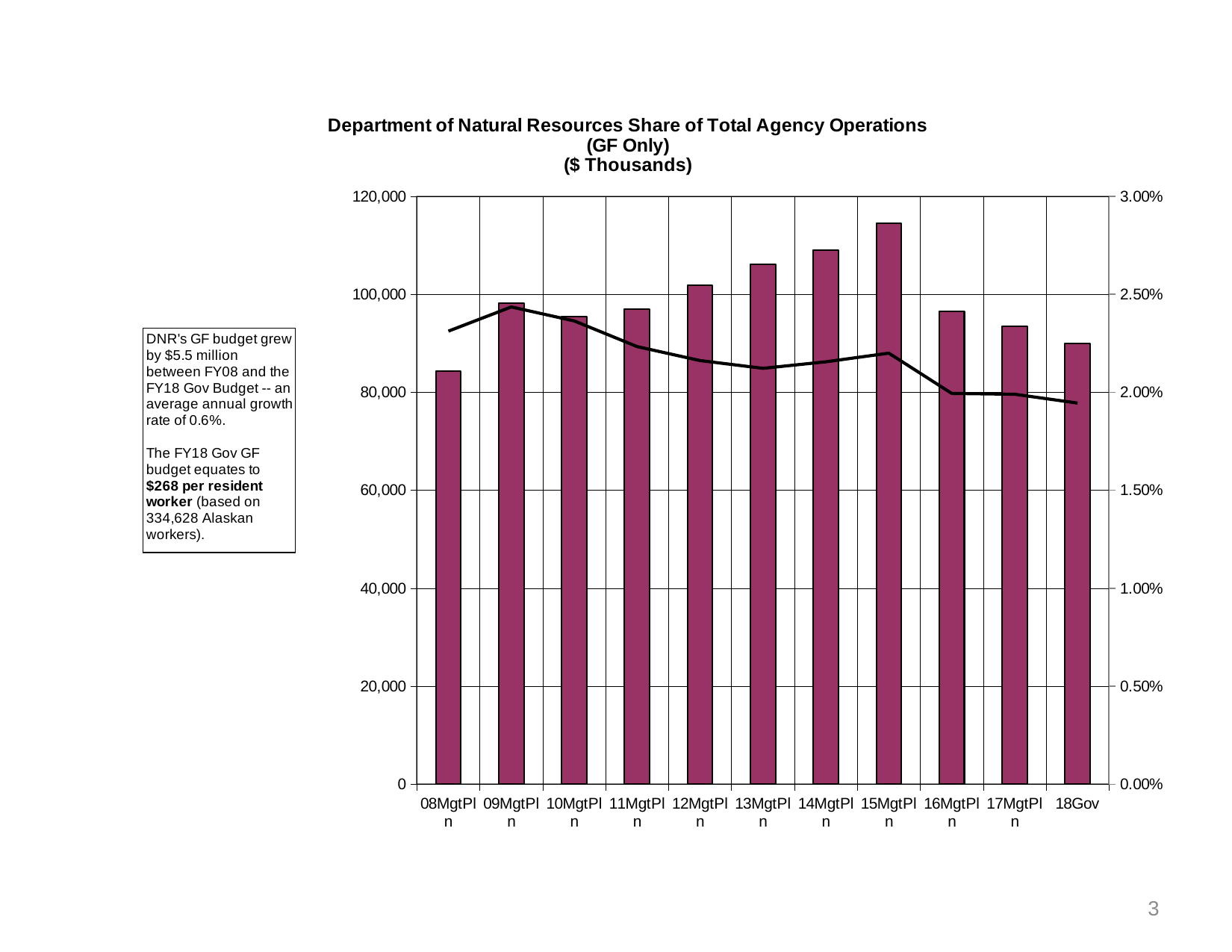
What kind of chart is shown on the slide? Bar chart with a line overlay Is the bar value for 18Gov greater or less than 100,000? less Which bar is taller, 08MgtPln or 09MgtPln? 09MgtPln At which category does the line (right-hand percentage axis) reach its highest point? 09MgtPln Is the bar value for 08MgtPln greater or less than 80,000? greater Is the line value for 09MgtPln greater or less than 2.00%? greater Which category has the tallest bar? 15MgtPln What is the title of the chart? Department of Natural Resources Share of Total Agency Operations (GF Only) ($ Thousands) Which category has the shortest bar? 08MgtPln How many fiscal-year categories are shown on the x axis? 11 Which bar is taller, 12MgtPln or 18Gov? 12MgtPln